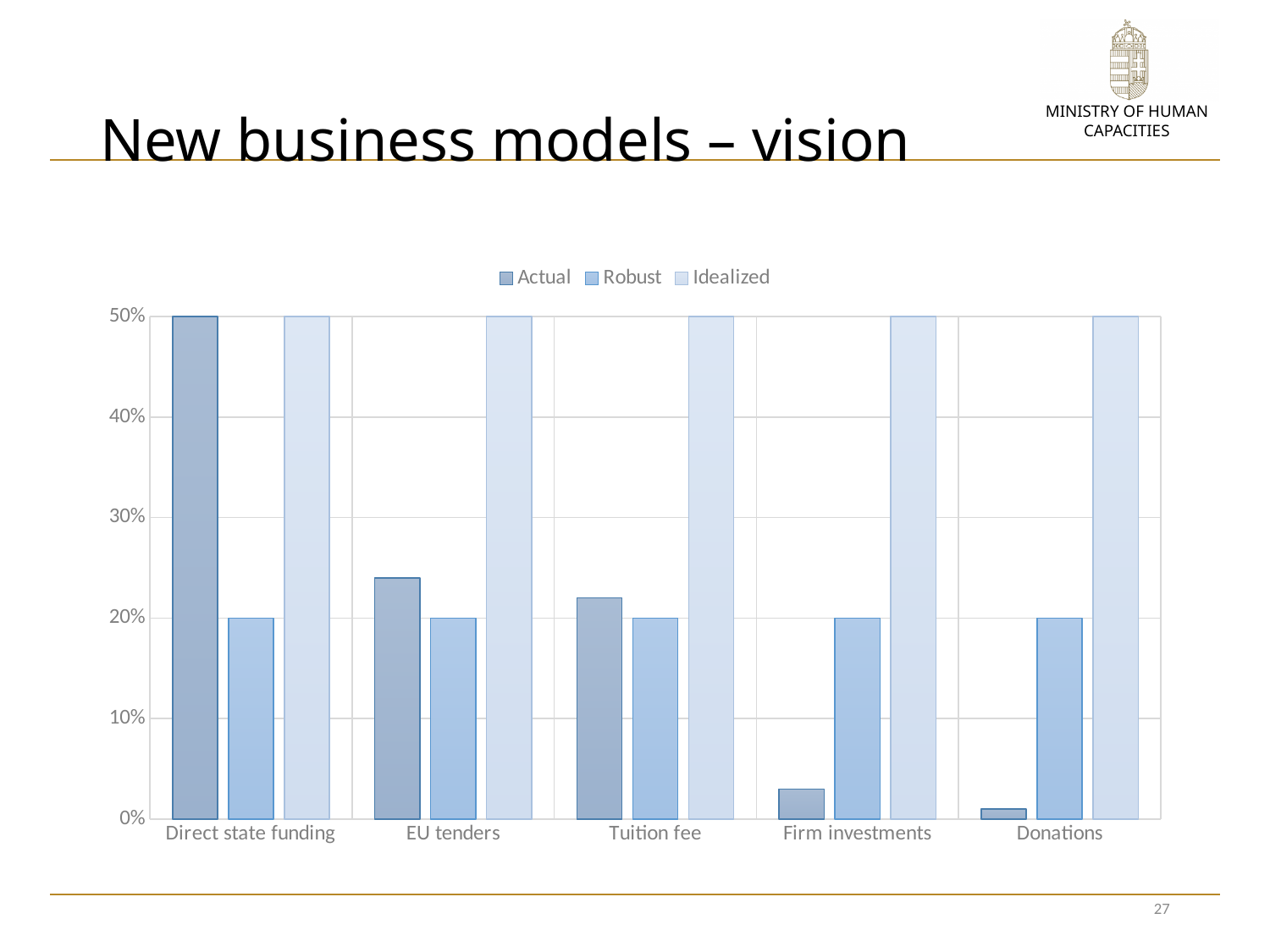
How many categories are shown on the x axis? 5 How many series does the legend list? 3 Is the Actual value for Firm investments greater or less than 10%? less Is the Actual value for EU tenders greater or less than 20%? greater What is the title of the slide containing the chart? New business models – vision What kind of chart is shown on the slide? bar chart What is the Actual value for Direct state funding? 50% Which category has the lowest Actual value? Donations Which category has the highest Actual value? Direct state funding What is the Robust value for Tuition fee? 20% What is the Idealized value for Donations? 50% Which is larger, the Actual value for Direct state funding or the Actual value for EU tenders? Direct state funding